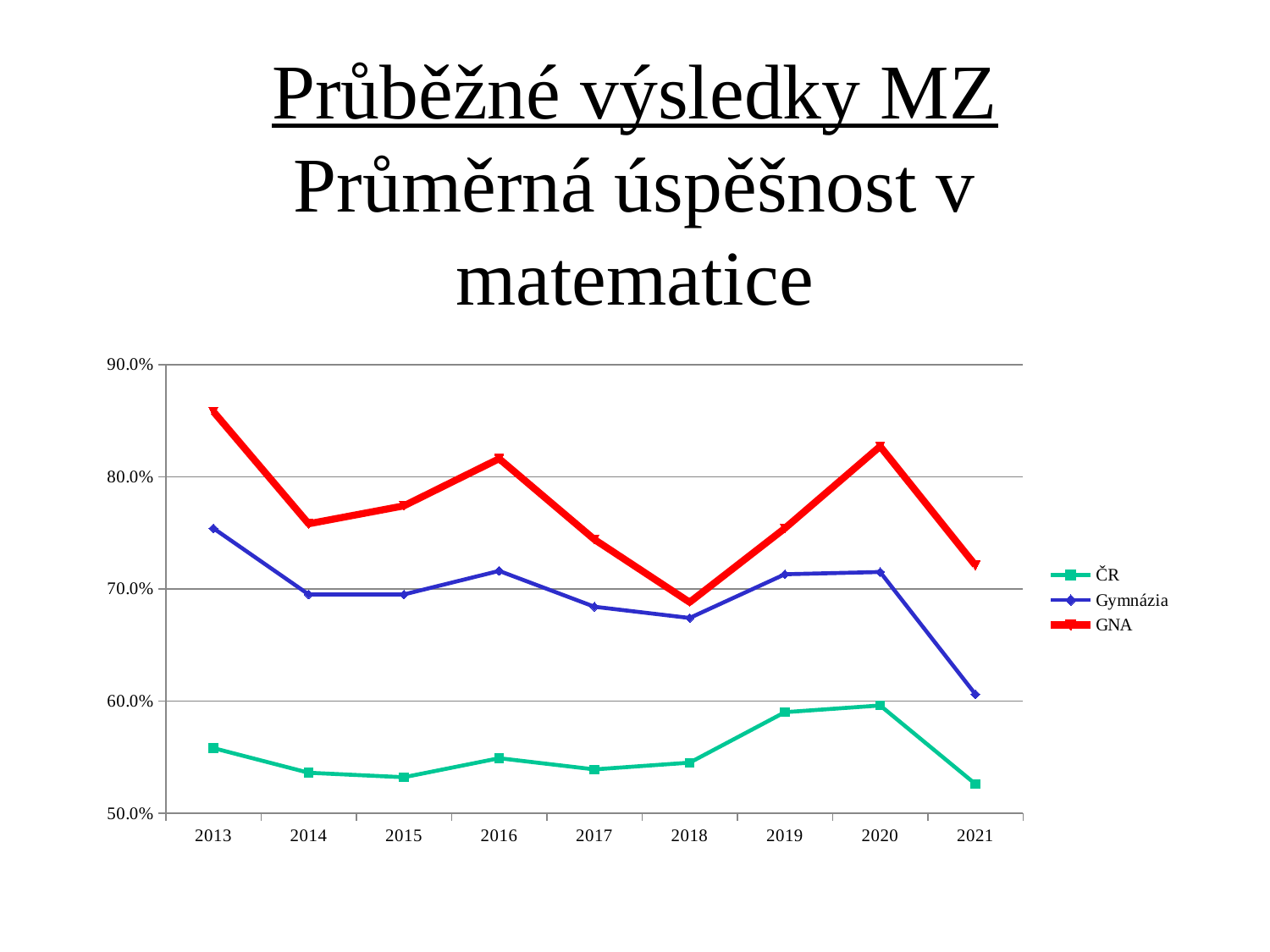
What colour is the GNA line? red In which year is the Gymnázia series at its lowest? 2021 How many years are shown on the x axis? 9 Is the value for GNA in 2013 greater or less than 80.0%? greater Which series has the higher value in 2016, GNA or Gymnázia? GNA In which year is the GNA series at its highest? 2013 Does the GNA series rise or fall from 2020 to 2021? fall In which year is the GNA series at its lowest? 2018 Is the value for GNA in 2018 greater or less than 70.0%? less How many series does the legend list? 3 Is the value for ČR in 2019 greater or less than 60.0%? less What kind of chart is shown on the slide? line chart